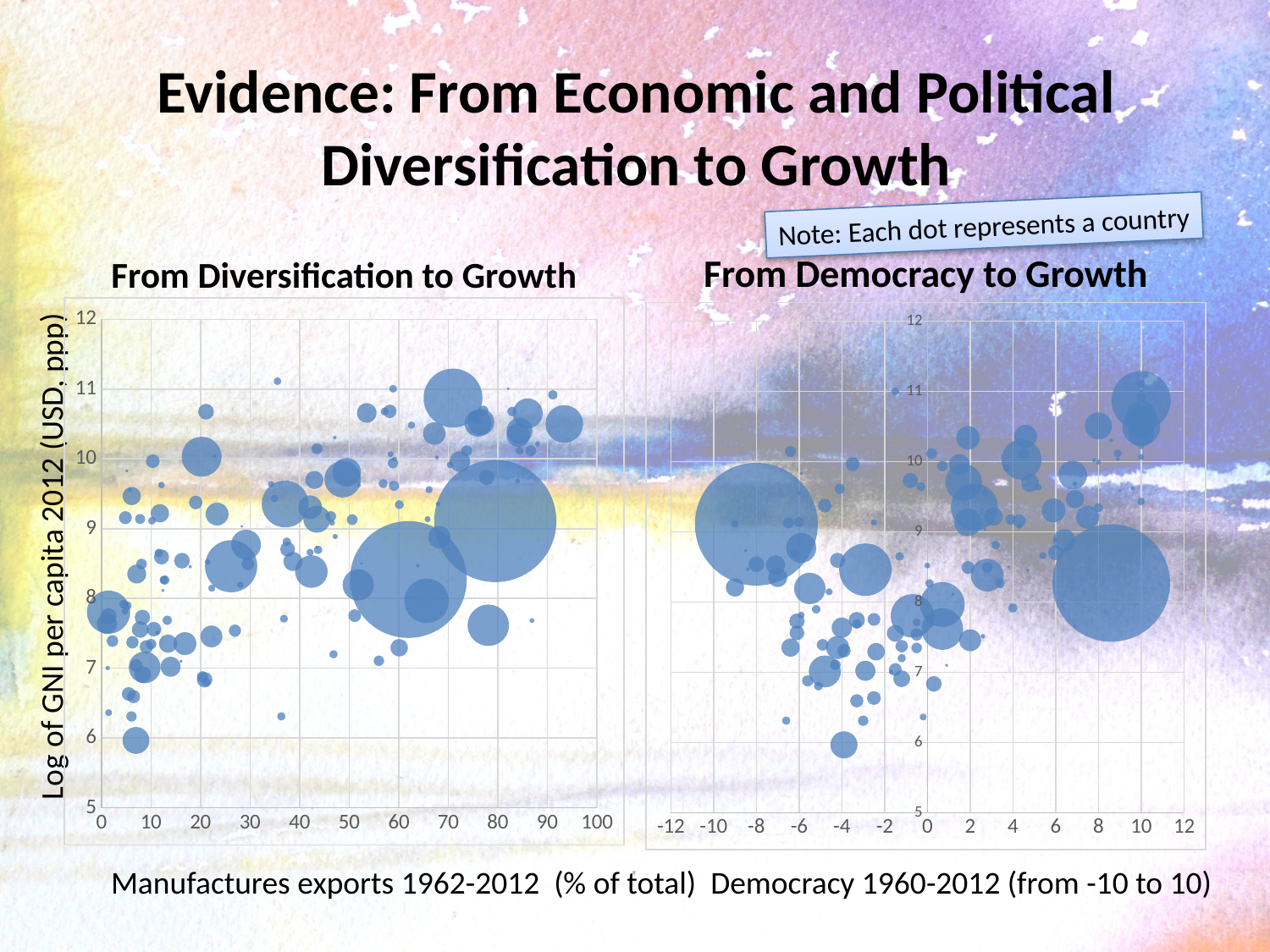
What is the label of the shared y axis for both charts? Log of GNI per capita 2012 (USD, ppp) According to the note on the slide, what does each dot in the charts represent? A country What is the highest value shown on the x axis of the left chart, "From Diversification to Growth"? 100 What range does the x axis of the right chart, "From Democracy to Growth", span? -12 to 12 In the left chart, "From Diversification to Growth", do the values on the y axis generally rise or fall as the x axis value increases? Rise What is the title of the chart on the left side of the slide? From Diversification to Growth What is the title of the chart on the right side of the slide? From Democracy to Growth What is the highest value shown on the y axis of the right chart, "From Democracy to Growth"? 12 What kind of chart is the right chart titled "From Democracy to Growth"? Bubble chart (scatter plot) What is the lowest value shown on the y axis of the left chart, "From Diversification to Growth"? 5 In the right chart, "From Democracy to Growth", do the values on the y axis generally rise or fall as the x axis value increases? Rise What kind of chart is the left chart titled "From Diversification to Growth"? Bubble chart (scatter plot)